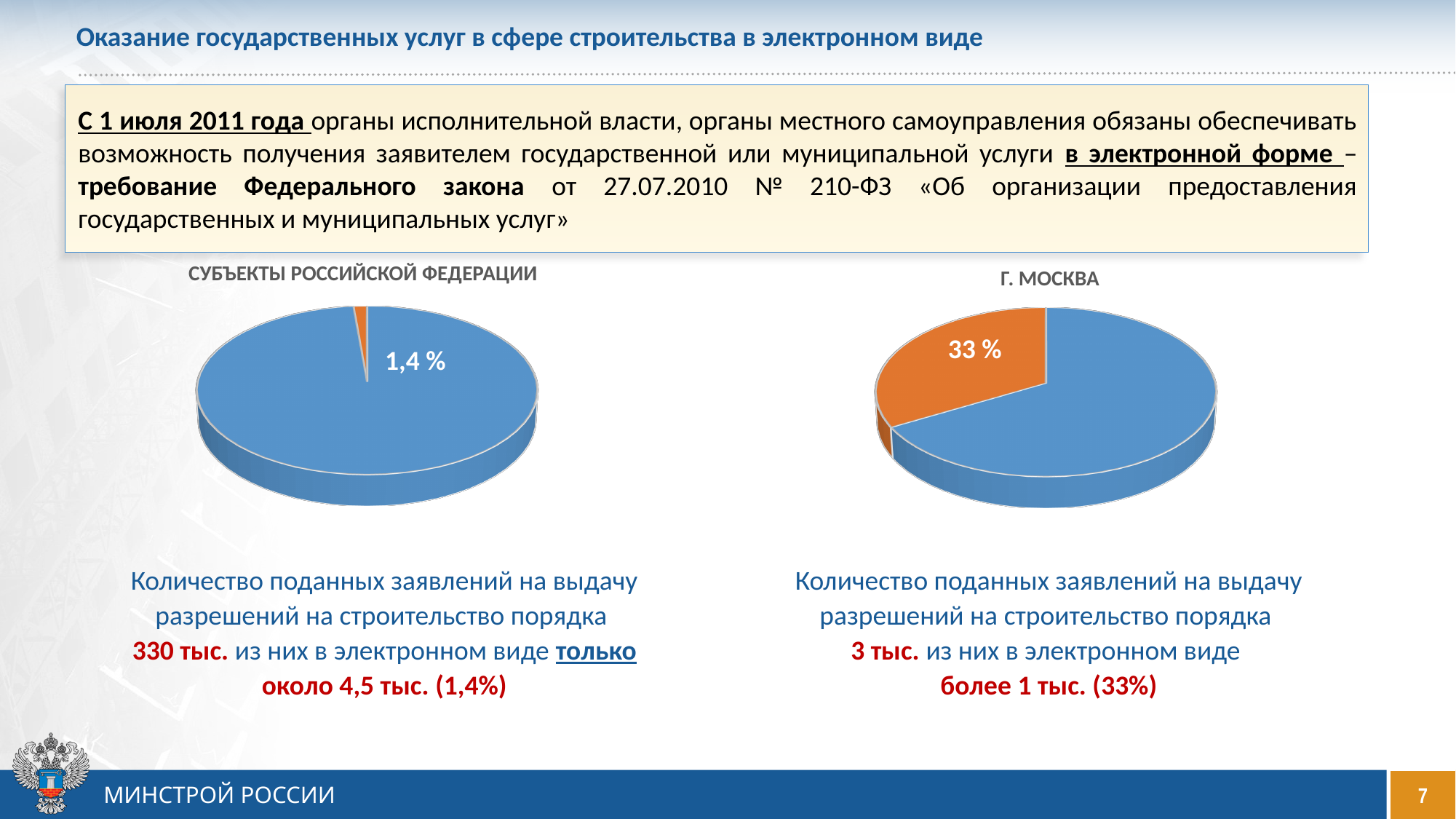
In the "Г. МОСКВА" pie chart, which slice is larger, the blue one or the orange one? The blue one In the "СУБЪЕКТЫ РОССИЙСКОЙ ФЕДЕРАЦИИ" pie chart, which slice is smaller, the blue one or the orange one? The orange one What is the title of the pie chart on the left side of the slide? СУБЪЕКТЫ РОССИЙСКОЙ ФЕДЕРАЦИИ In the "Г. МОСКВА" pie chart, what share is printed on the orange slice? 33 % How many slices does the "СУБЪЕКТЫ РОССИЙСКОЙ ФЕДЕРАЦИИ" pie chart have? 2 Which pie chart has the larger orange slice, "СУБЪЕКТЫ РОССИЙСКОЙ ФЕДЕРАЦИИ" or "Г. МОСКВА"? Г. МОСКВА What kind of chart is shown under the heading "СУБЪЕКТЫ РОССИЙСКОЙ ФЕДЕРАЦИИ"? Pie chart How many pie charts are shown on the slide? 2 What is the title of the pie chart on the right side of the slide? Г. МОСКВА In the "СУБЪЕКТЫ РОССИЙСКОЙ ФЕДЕРАЦИИ" pie chart, what share is printed on the orange slice? 1,4 % What kind of chart is shown under the heading "Г. МОСКВА"? Pie chart How many slices does the "Г. МОСКВА" pie chart have? 2